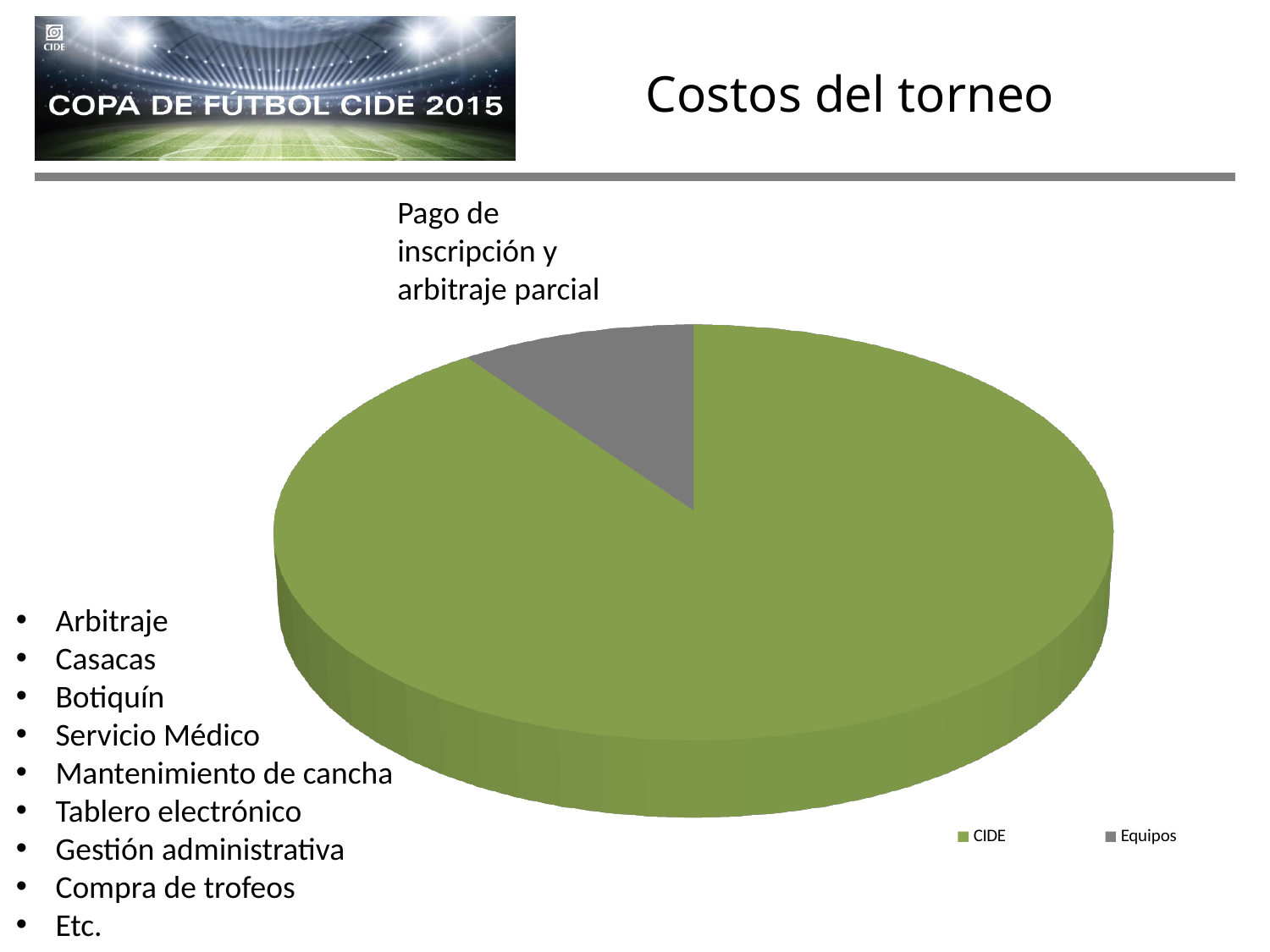
How many entries does the legend of the pie chart list? 2 What kind of chart is shown on the slide? Pie chart Which category has the largest slice in the pie chart? CIDE What colour is the Equipos slice in the pie chart? Gray What colour is the CIDE slice in the pie chart? Green Which category has the smallest slice in the pie chart? Equipos How many slices does the pie chart have? 2 Which slice is larger in the pie chart, CIDE or Equipos? CIDE